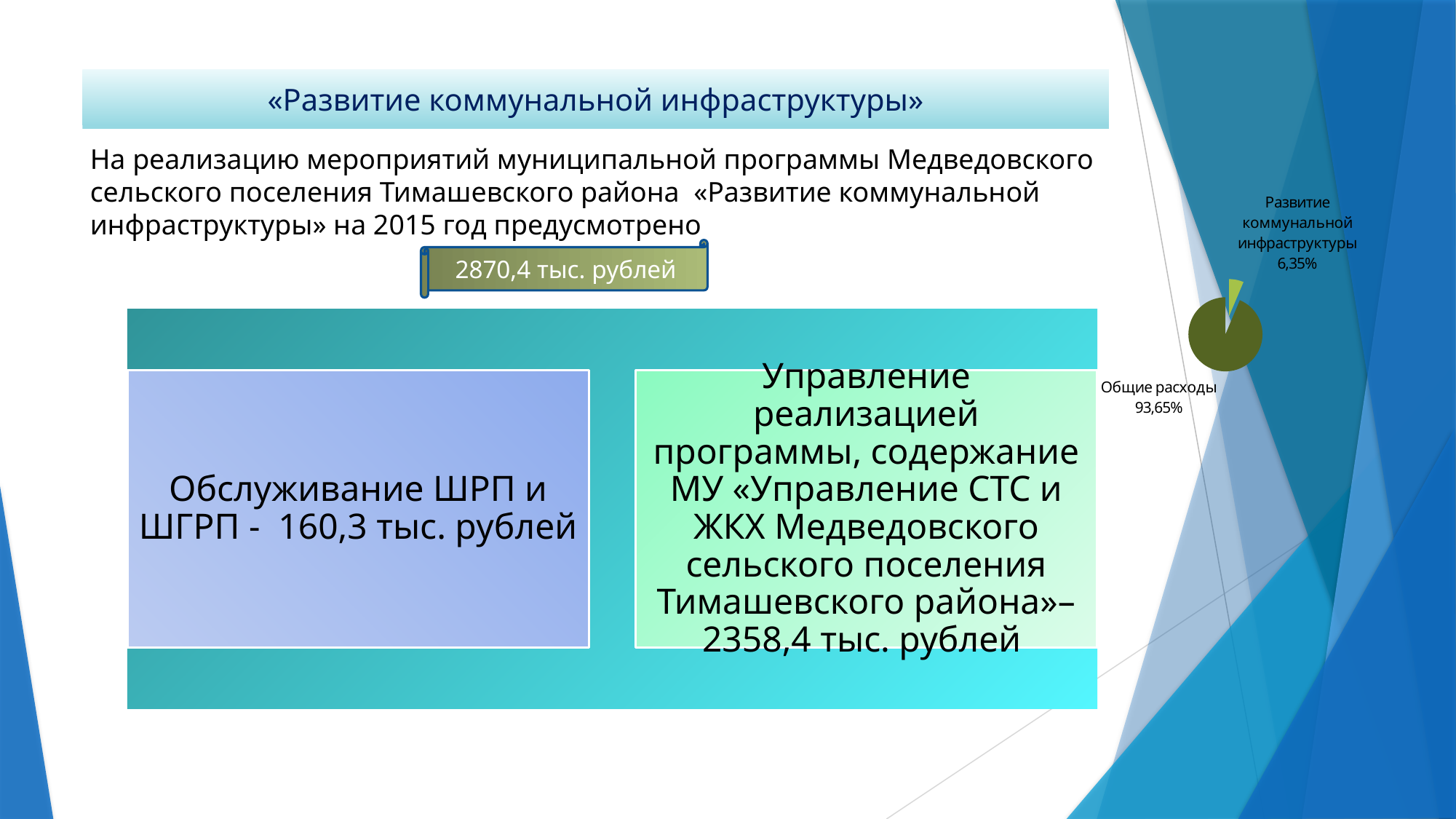
What is the total of the two percentages shown on the pie chart? 100% Which slice of the pie chart is the largest? Общие расходы What is the difference in percentage points between the "Общие расходы" slice and the "Развитие коммунальной инфраструктуры" slice in the pie chart? 87,30 What share of the pie chart is labelled "Общие расходы"? 93,65% Which slice of the pie chart is the smallest? Развитие коммунальной инфраструктуры Does the pie chart have a legend? No How many slices does the pie chart have? 2 In the pie chart, which is larger: "Общие расходы" or "Развитие коммунальной инфраструктуры"? Общие расходы What share of the pie chart is labelled "Развитие коммунальной инфраструктуры"? 6,35% What colour is the "Общие расходы" slice of the pie chart? dark olive green What kind of chart is shown on the right side of the slide? pie chart